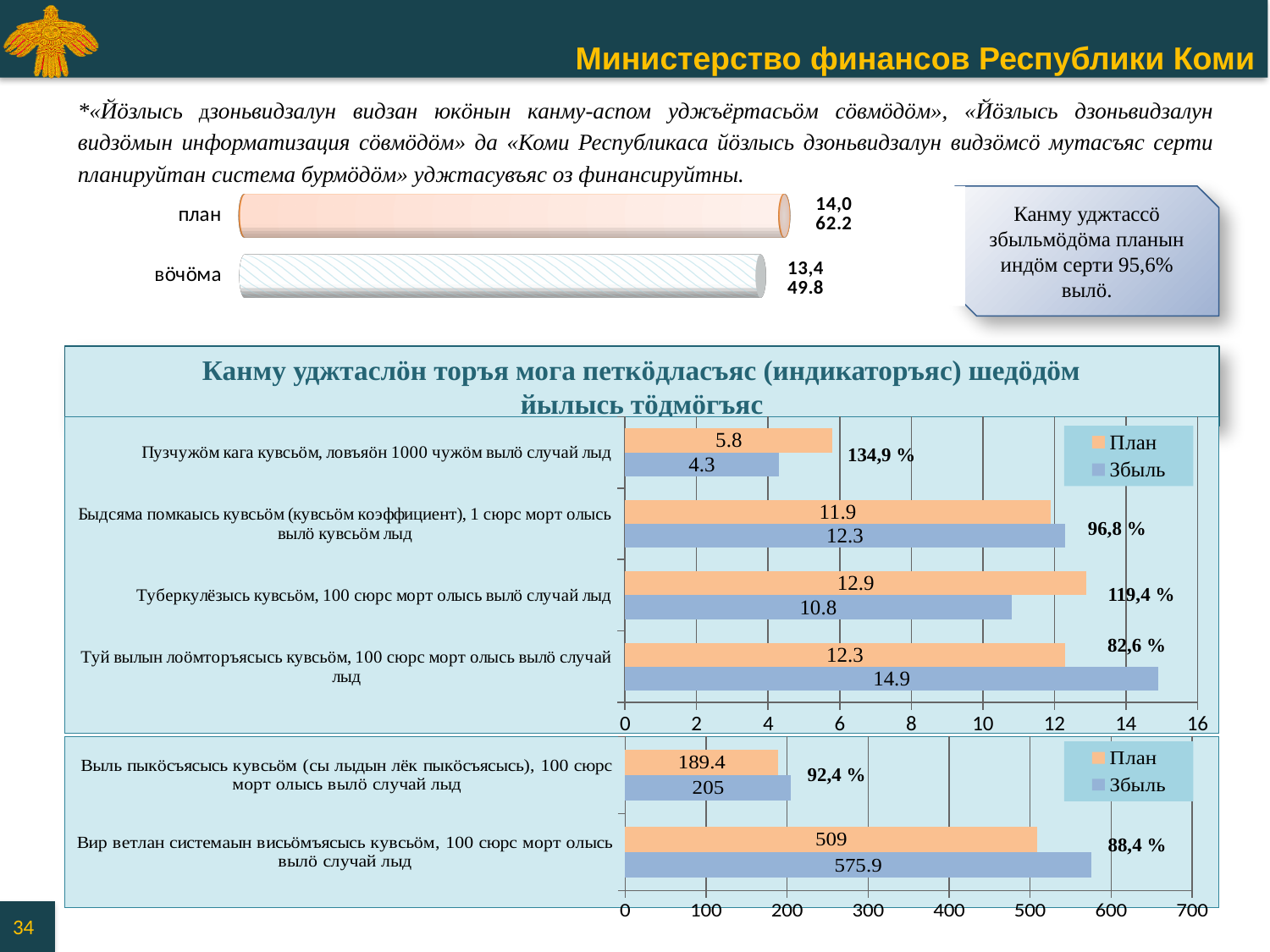
In the middle chart, what is the Збыль value for Пузчужöм кага кувсьöм? 4.3 In the bottom chart, is the Збыль value for Вир ветлан системаын висьöмъясысь кувсьöм greater or less than 500? greater In the middle chart, which category has the lowest План value? Пузчужöм кага кувсьöм How many series does the legend of the bottom chart list? 2 In the bottom chart, what is the Збыль value for Вир ветлан системаын висьöмъясысь кувсьöм? 575.9 In the bottom chart, what is the План value for Выль пыкöсъясысь кувсьöм? 189.4 How many categories does the middle chart show? 4 In the middle chart, which category has the highest Збыль value? Туй вылын лоöмторъясысь кувсьöм In the middle chart, what is the difference between the Збыль and План values for Туй вылын лоöмторъясысь кувсьöм? 2.6 What kind of chart is the bottom chart? bar chart In the middle chart, what is the План value for Туберкулёзысь кувсьöм? 12.9 In the middle chart, for Быдсяма помкаысь кувсьöм, which is larger: План or Збыль? Збыль